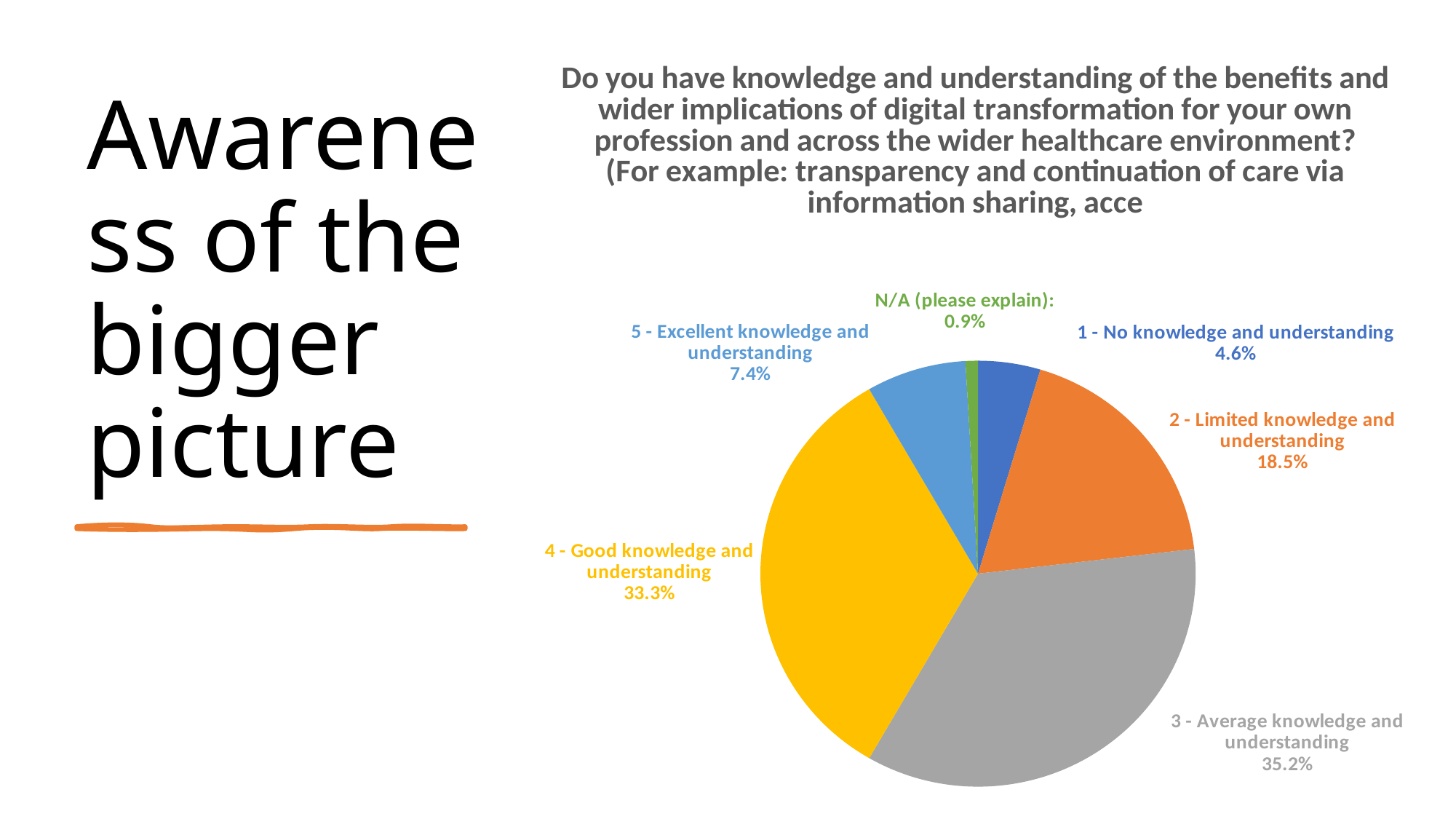
What kind of chart is shown on the slide? pie chart Which category has the largest slice of the pie? 3 - Average knowledge and understanding What share of respondents answered 'N/A (please explain)'? 0.9% Which is larger: the share for '5 - Excellent knowledge and understanding' or the share for '1 - No knowledge and understanding'? 5 - Excellent knowledge and understanding Which category has the smallest slice of the pie? N/A (please explain) What is the difference in percentage points between '2 - Limited knowledge and understanding' and '1 - No knowledge and understanding'? 13.9 What share of respondents reported '2 - Limited knowledge and understanding'? 18.5% What share of respondents reported '4 - Good knowledge and understanding'? 33.3% What share of respondents reported '1 - No knowledge and understanding'? 4.6% What share of respondents reported '3 - Average knowledge and understanding'? 35.2% What share of respondents reported '5 - Excellent knowledge and understanding'? 7.4% How many slices does the pie chart have? 6